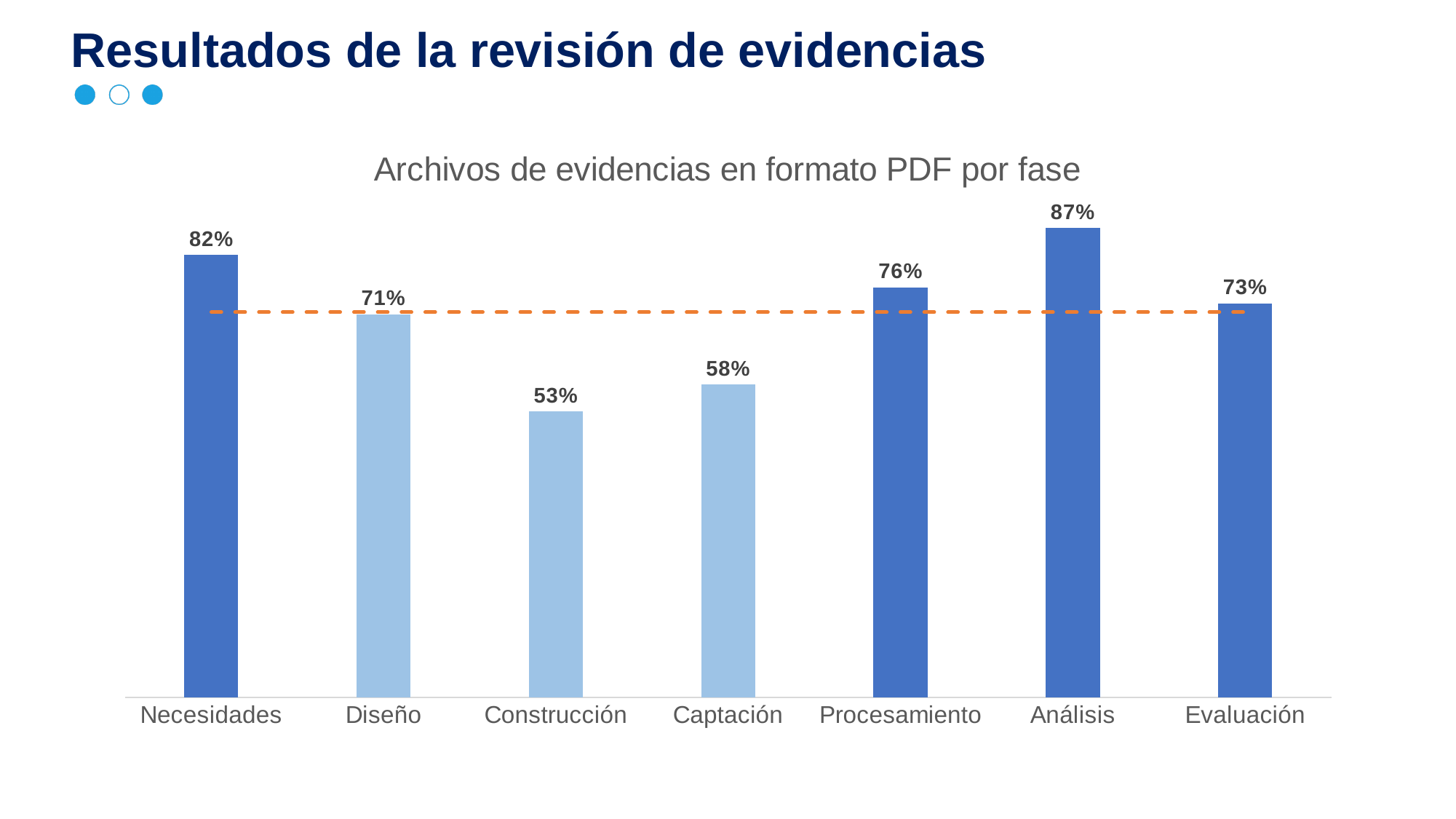
What is the value for Procesamiento? 76% What kind of chart is this? Bar chart What is the difference between the values for Necesidades and Diseño? 11% What is the value for Construcción? 53% How many phases are shown on the x axis? 7 What is the title of the chart? Archivos de evidencias en formato PDF por fase What is the difference between the values for Análisis and Construcción? 34% What is the value for Necesidades? 82% Which phase has the highest value? Análisis How many bars are drawn in the lighter blue colour? 3 Which is larger, the value for Captación or the value for Evaluación? Evaluación Which phase has the lowest value? Construcción